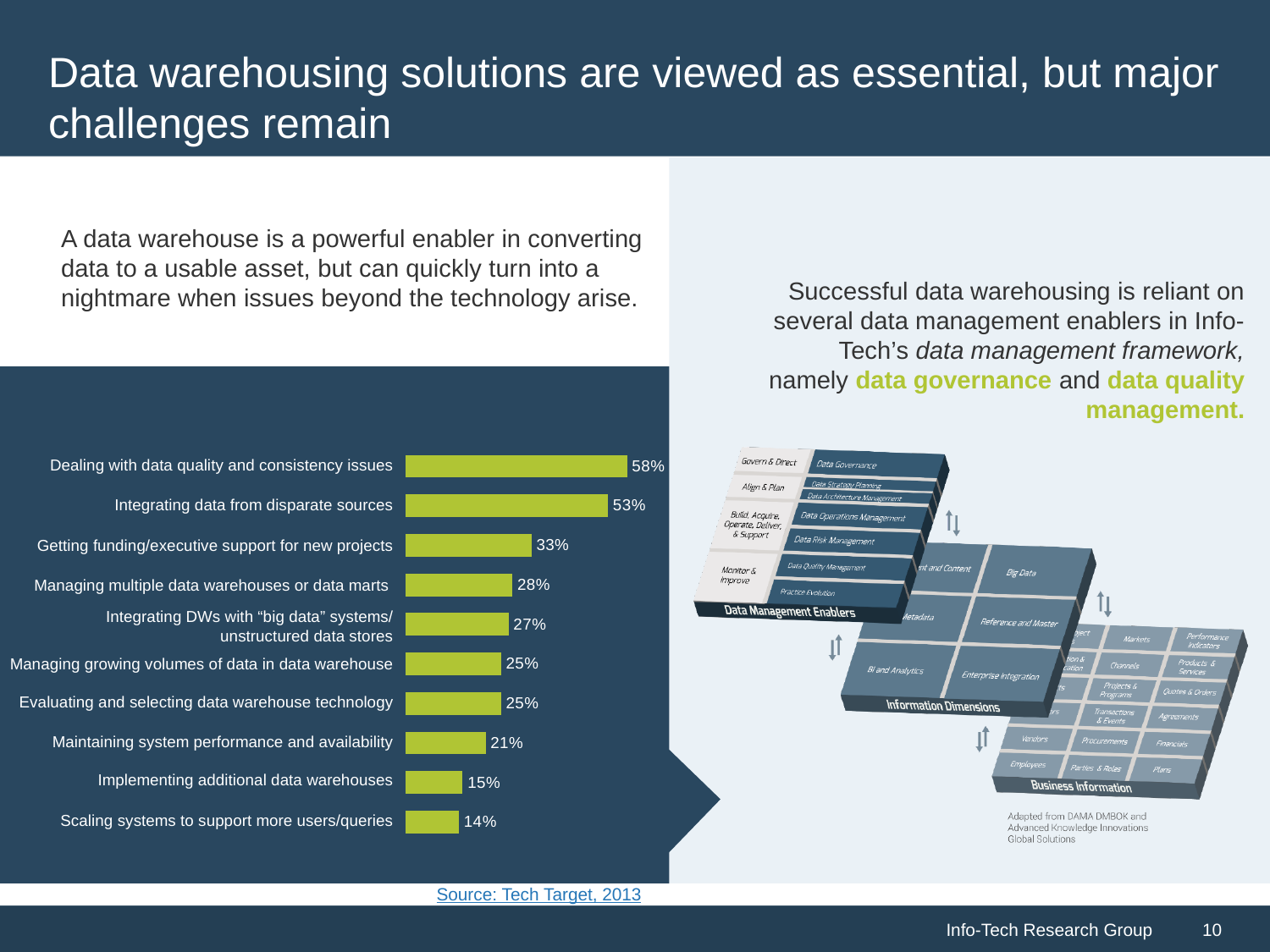
What is the difference in percentage points between "Dealing with data quality and consistency issues" and "Integrating data from disparate sources"? 5 What is the difference in percentage points between "Getting funding/executive support for new projects" and "Maintaining system performance and availability"? 12 Which two challenges share the same value of 25%? Managing growing volumes of data in data warehouse; Evaluating and selecting data warehouse technology What source is cited for the bar chart? Tech Target, 2013 How many challenges (categories) are listed in the bar chart? 10 Which is larger: the value for "Managing multiple data warehouses or data marts" or the value for "Maintaining system performance and availability"? Managing multiple data warehouses or data marts Which challenge has the highest percentage in the bar chart? Dealing with data quality and consistency issues What percentage is shown for "Implementing additional data warehouses"? 15% What value is shown for "Getting funding/executive support for new projects"? 33% What type of chart is shown on the left side of the slide? Bar chart Which challenge has the lowest percentage in the bar chart? Scaling systems to support more users/queries What percentage is shown for "Dealing with data quality and consistency issues"? 58%